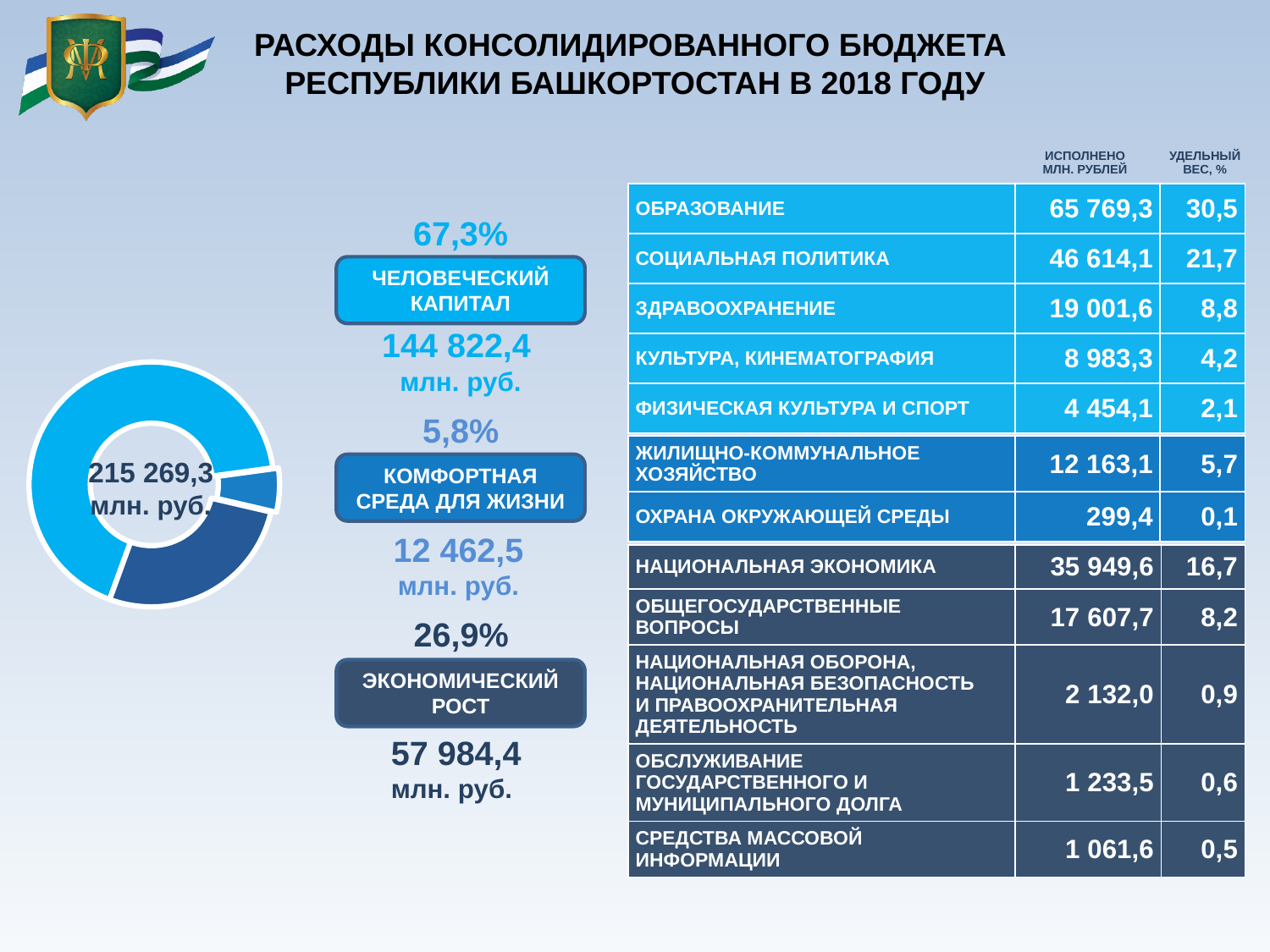
What is the value in млн. руб. for КОМФОРТНАЯ СРЕДА ДЛЯ ЖИЗНИ? 12 462,5 млн. руб. What is the value in млн. руб. for ЧЕЛОВЕЧЕСКИЙ КАПИТАЛ? 144 822,4 млн. руб. How many segments does the donut chart have? 3 Which segment of the donut chart is the smallest? КОМФОРТНАЯ СРЕДА ДЛЯ ЖИЗНИ What share of the donut chart does ЭКОНОМИЧЕСКИЙ РОСТ represent? 26,9% What share of the donut chart does ЧЕЛОВЕЧЕСКИЙ КАПИТАЛ represent? 67,3% What kind of chart is shown on the left of the slide? Donut (pie) chart Which segment of the donut chart is the largest? ЧЕЛОВЕЧЕСКИЙ КАПИТАЛ Which is larger, the share for ЭКОНОМИЧЕСКИЙ РОСТ or the share for КОМФОРТНАЯ СРЕДА ДЛЯ ЖИЗНИ? ЭКОНОМИЧЕСКИЙ РОСТ What share of the donut chart does КОМФОРТНАЯ СРЕДА ДЛЯ ЖИЗНИ represent? 5,8% What total value is shown in the centre of the donut chart? 215 269,3 млн. руб. What is the value in млн. руб. for ЭКОНОМИЧЕСКИЙ РОСТ? 57 984,4 млн. руб.